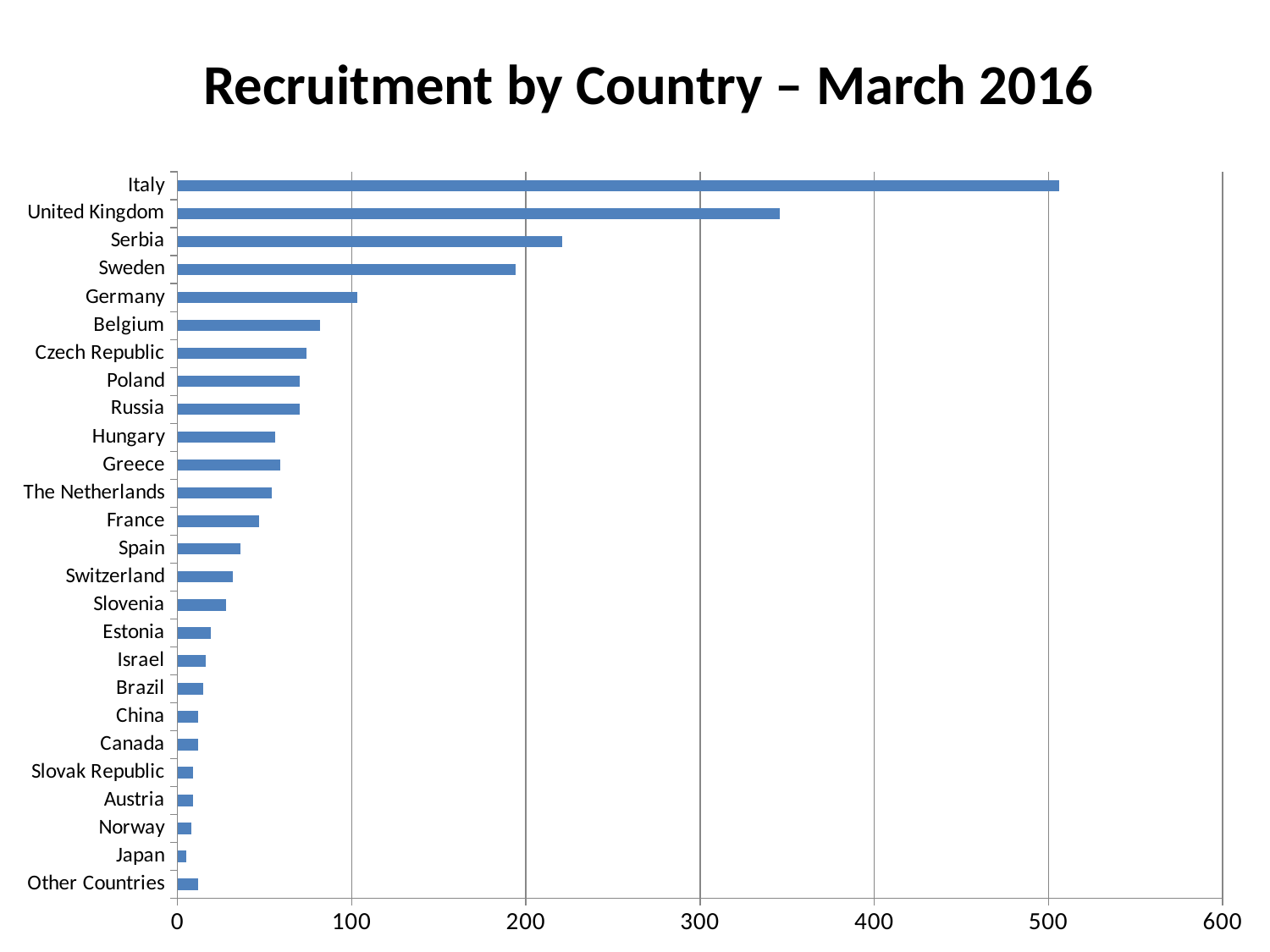
Is the value for Serbia greater or less than 200? greater What type of chart is shown on the slide? Bar chart Which has a larger value, Sweden or Germany? Sweden Which country has the highest recruitment value? Italy What is the title of the chart? Recruitment by Country – March 2016 Which country has the lowest recruitment value? Japan Which has a larger value, United Kingdom or Serbia? United Kingdom How many categories are plotted on the chart? 26 Is the value for Italy greater or less than 400? greater Is the value for United Kingdom greater or less than 300? greater